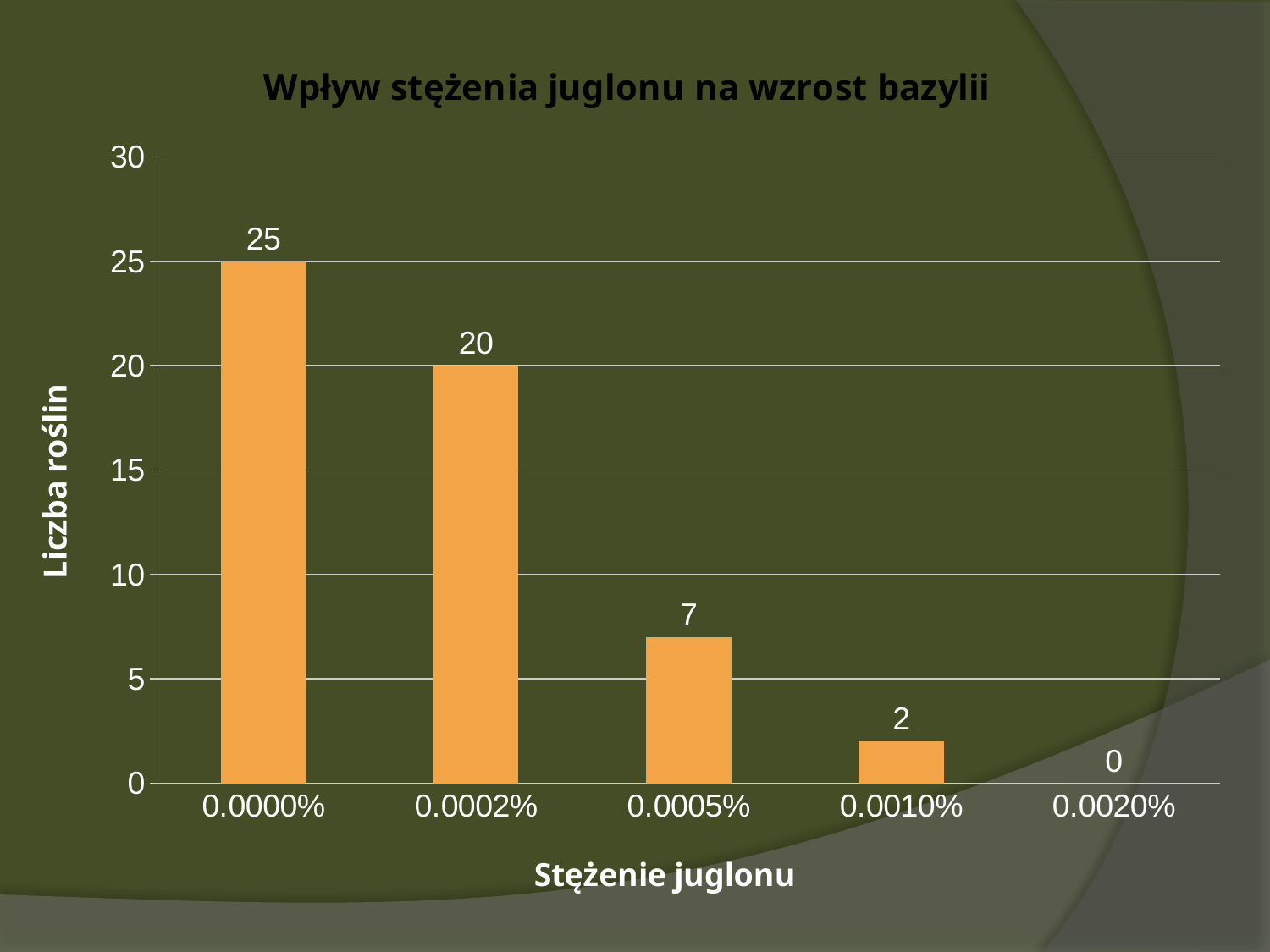
Which juglone concentration has the highest number of plants? 0.0000% What is the difference in the number of plants between the 0.0000% and 0.0002% concentrations? 5 What is the number of plants at a juglone concentration of 0.0005%? 7 Which has more plants: the 0.0005% concentration or the 0.0010% concentration? 0.0005% What is the number of plants at a juglone concentration of 0.0020%? 0 What is the difference in the number of plants between the 0.0005% and 0.0010% concentrations? 5 What kind of chart is shown on the slide? Bar chart Which juglone concentration has the lowest number of plants? 0.0020% How many concentration categories are shown on the x axis? 5 What is the number of plants (Liczba roślin) at a juglone concentration of 0.0000%? 25 What is the number of plants at a juglone concentration of 0.0002%? 20 Do the values rise or fall as the juglone concentration increases along the x axis? Fall